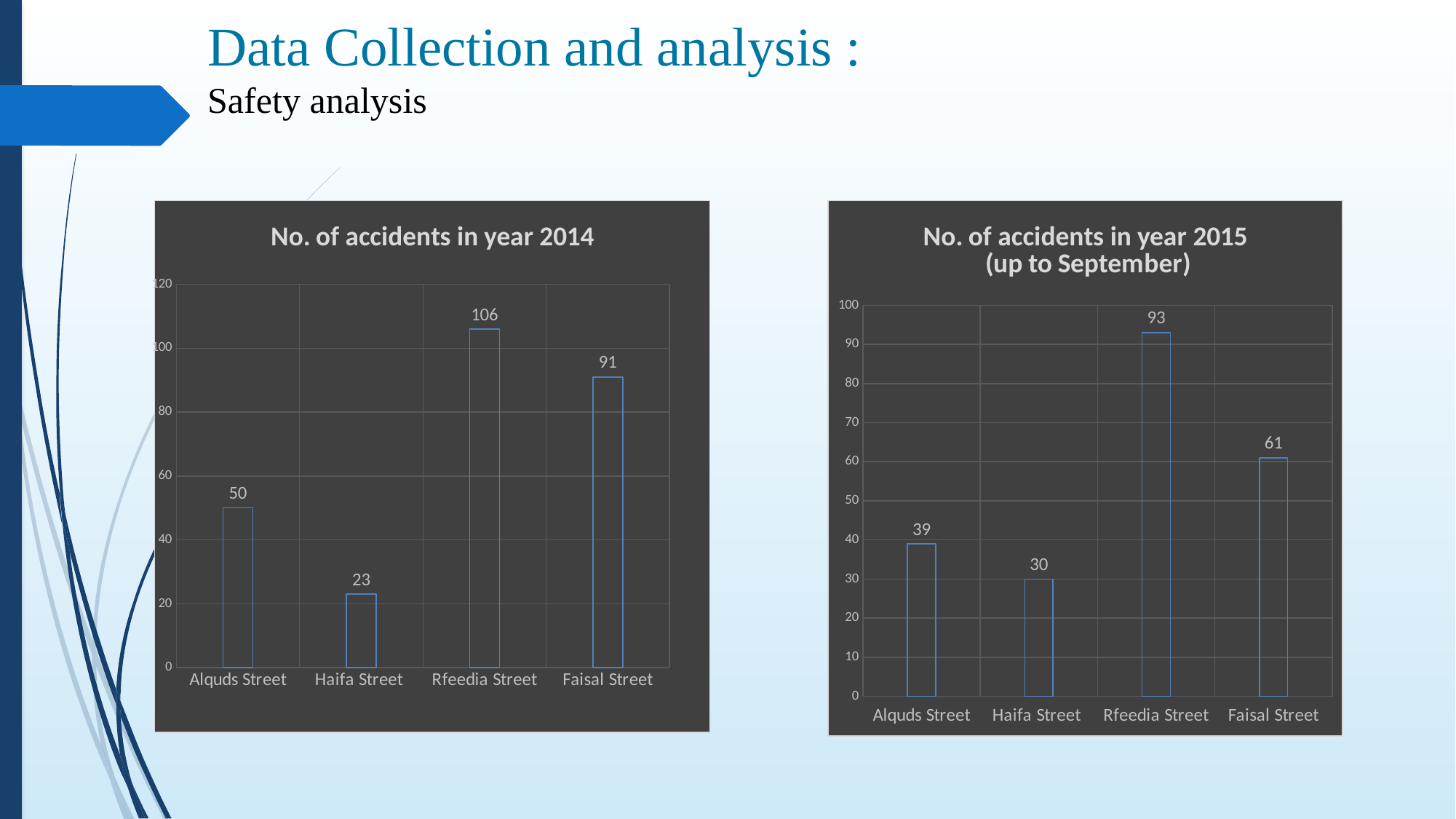
In the 'No. of accidents in year 2014' chart, what is the value for Rfeedia Street? 106 What kind of chart is the 'No. of accidents in year 2015 (up to September)' chart? bar chart In the 'No. of accidents in year 2014' chart, what is the difference between Rfeedia Street and Faisal Street? 15 In the 'No. of accidents in year 2015 (up to September)' chart, what is the value for Haifa Street? 30 In the 'No. of accidents in year 2014' chart, which street has the lowest number of accidents? Haifa Street In the 'No. of accidents in year 2015 (up to September)' chart, which street has the highest number of accidents? Rfeedia Street In the 'No. of accidents in year 2014' chart, what is the value for Alquds Street? 50 In the 'No. of accidents in year 2015 (up to September)' chart, what is the difference between Faisal Street and Alquds Street? 22 In the 'No. of accidents in year 2015 (up to September)' chart, is the value for Faisal Street greater or less than 50? greater In the 'No. of accidents in year 2014' chart, which is larger, Alquds Street or Haifa Street? Alquds Street How many streets are shown in the 'No. of accidents in year 2014' chart? 4 What is the title of the chart on the left side of the slide? No. of accidents in year 2014